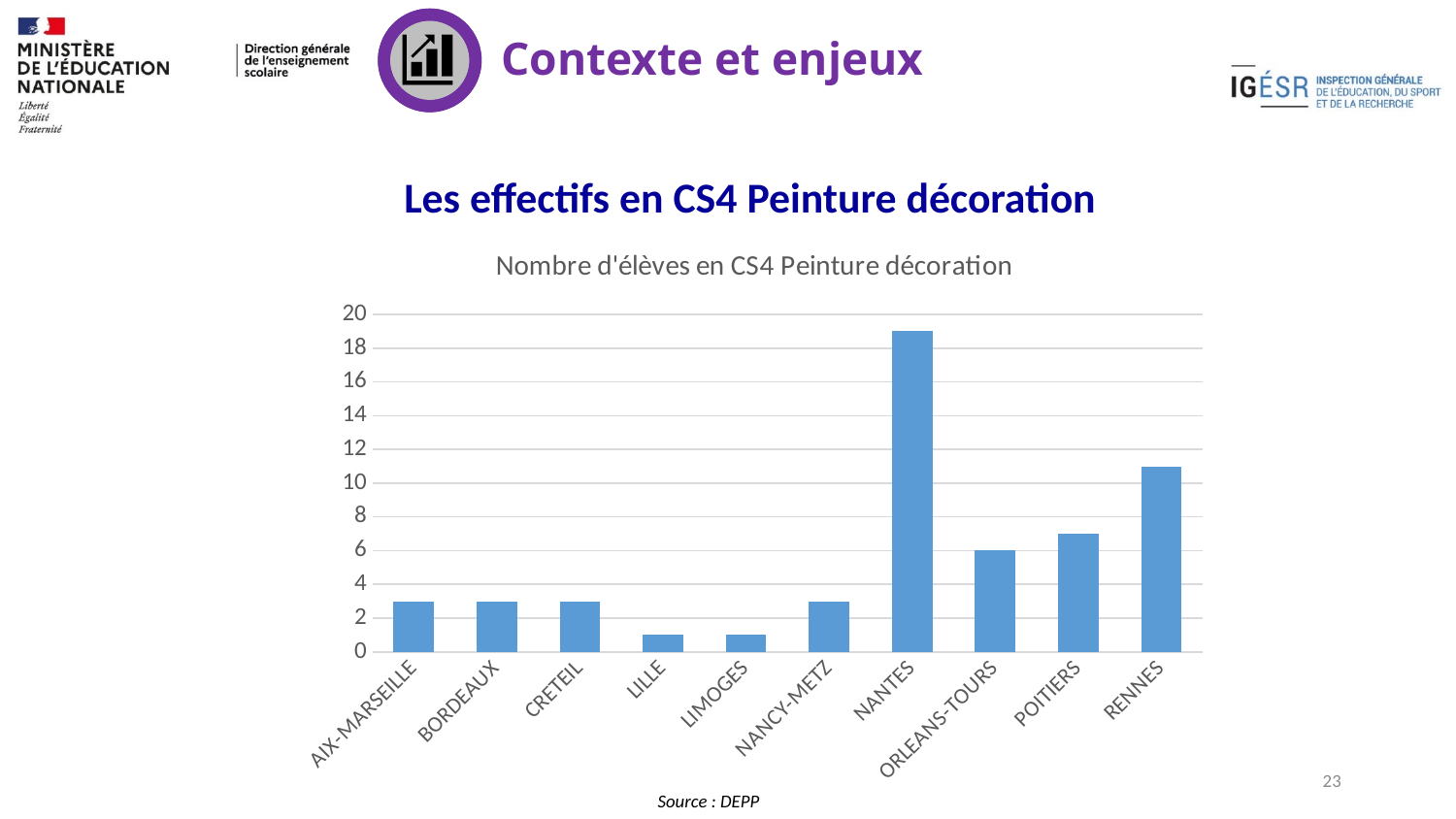
Which is larger, the value for RENNES or the value for POITIERS? RENNES Is the value for NANTES greater or less than 18? greater Is the value for AIX-MARSEILLE greater or less than 4? less How many academies (categories) are shown on the x axis of the chart? 10 Is the value for LILLE greater or less than 2? less What is the title of the chart? Nombre d'élèves en CS4 Peinture décoration What kind of chart is shown on the slide? bar chart Which academy has the highest number of students in CS4 Peinture décoration? NANTES What source is cited below the chart? DEPP Which is larger, the value for NANTES or the value for RENNES? NANTES